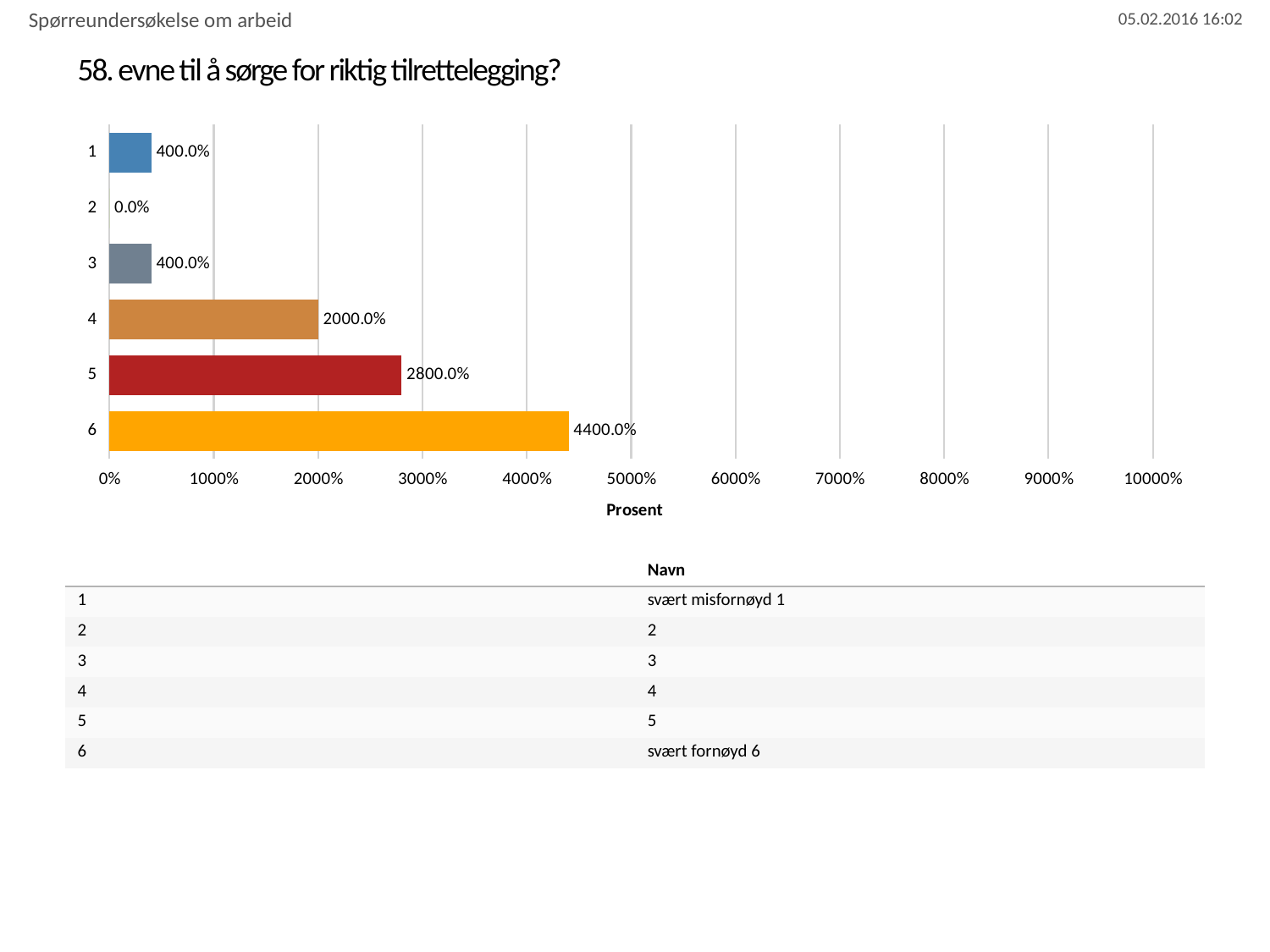
What kind of chart is shown on the slide? bar chart What is the value for category 2? 0.0% What is the difference between the values for category 5 and category 4? 800.0% What is the value for category 4? 2000.0% What is the value for category 6? 4400.0% Is the value for category 6 greater or less than 4000%? greater What is the difference between the values for category 6 and category 5? 1600.0% How many categories are shown on the chart? 6 Which category has the highest value? 6 Which is larger, the value for category 4 or the value for category 5? 5 Which category has the lowest value? 2 What is the label of the horizontal axis? Prosent